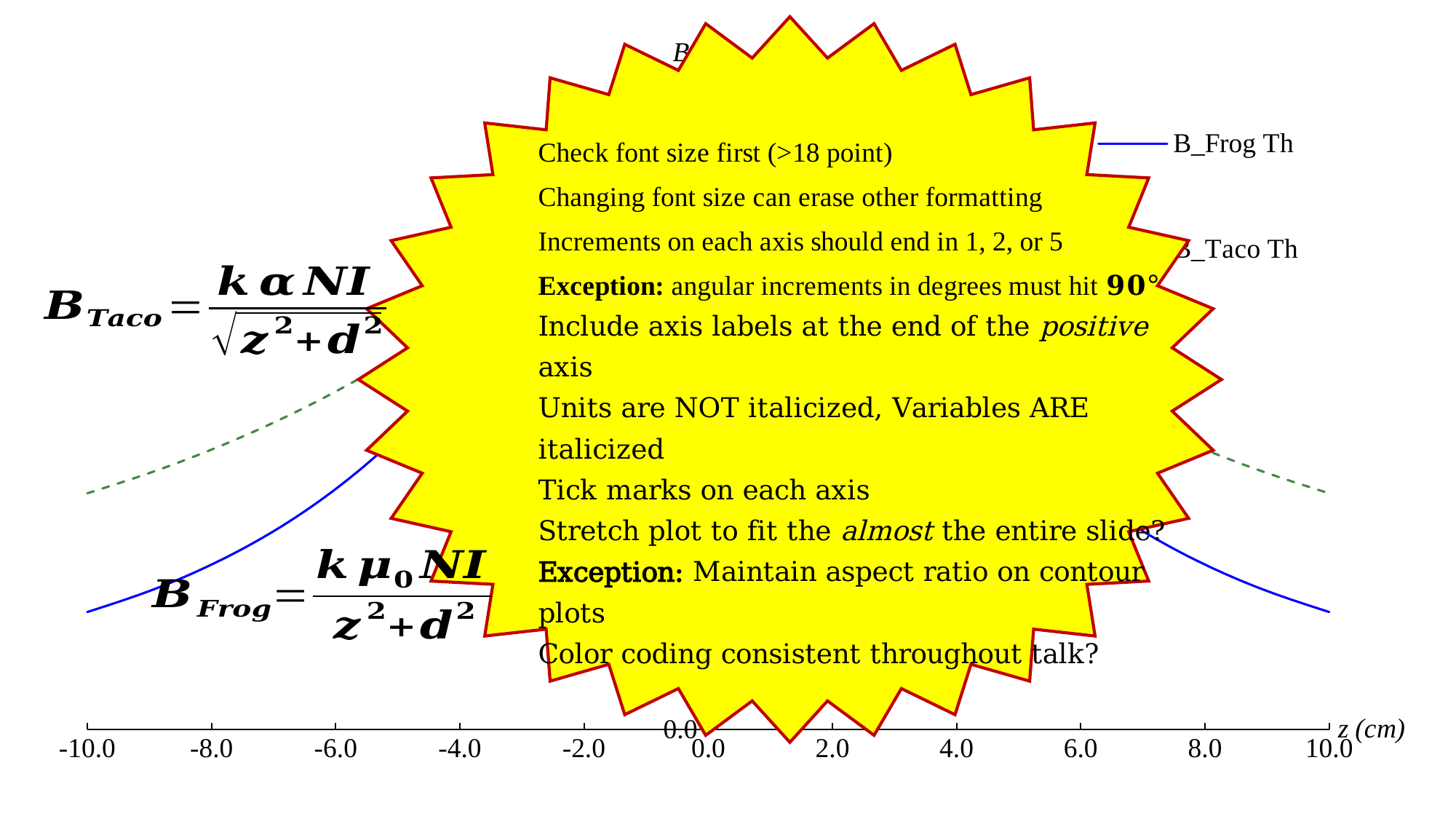
At z = 10.0, which curve has the larger value, B_Frog Th or B_Taco Th? B_Taco Th What kind of chart is shown on the slide? line chart How many tick labels are shown along the x axis? 11 What is the highest value labelled on the x axis? 10.0 Does the B_Frog Th curve rise or fall as z increases from 0.0 toward 10.0? fall Which series is drawn as a solid blue line? B_Frog Th Does the B_Frog Th curve rise or fall as z increases from -10.0 toward 0.0? rise At z = -10.0, which curve has the larger value, B_Frog Th or B_Taco Th? B_Taco Th How many series does the legend list? 2 What is the lowest value labelled on the x axis? -10.0 What is the label on the x axis of the chart? z (cm)